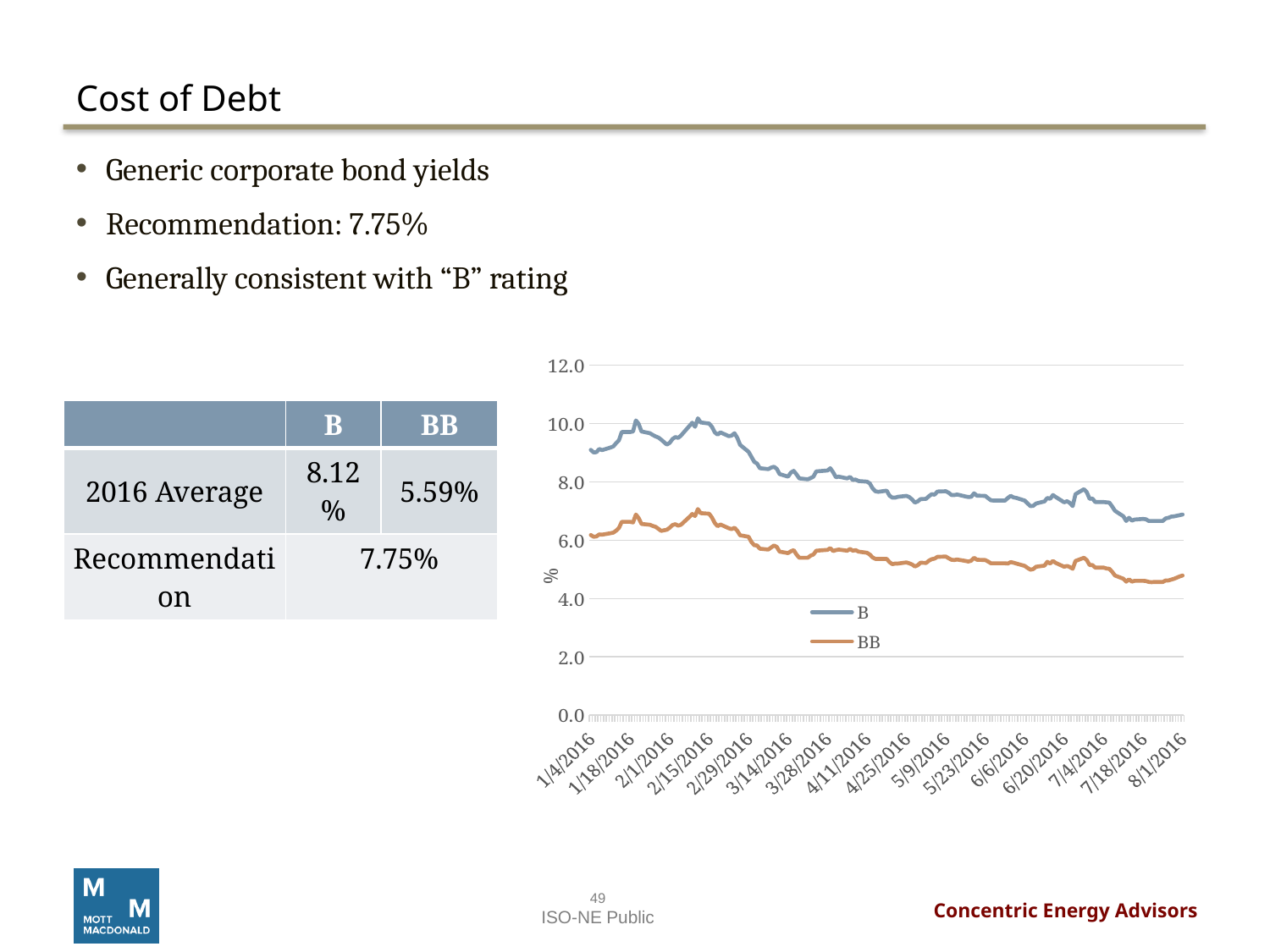
How many series does the chart legend list? 2 Is the value for B at 4/11/2016 greater or less than 6.0? greater What kind of chart is shown on the slide? Line chart Do the values of the B series generally rise or fall from 1/4/2016 to 8/1/2016? Fall Is the value for BB at 8/1/2016 greater or less than 6.0? less What is the label on the chart's vertical axis? % Do the values of the BB series generally rise or fall from 1/4/2016 to 8/1/2016? Fall Is the value for B at 1/4/2016 greater or less than 8.0? greater What are the two series named in the chart legend? B and BB Which series has higher values throughout the chart, B or BB? B